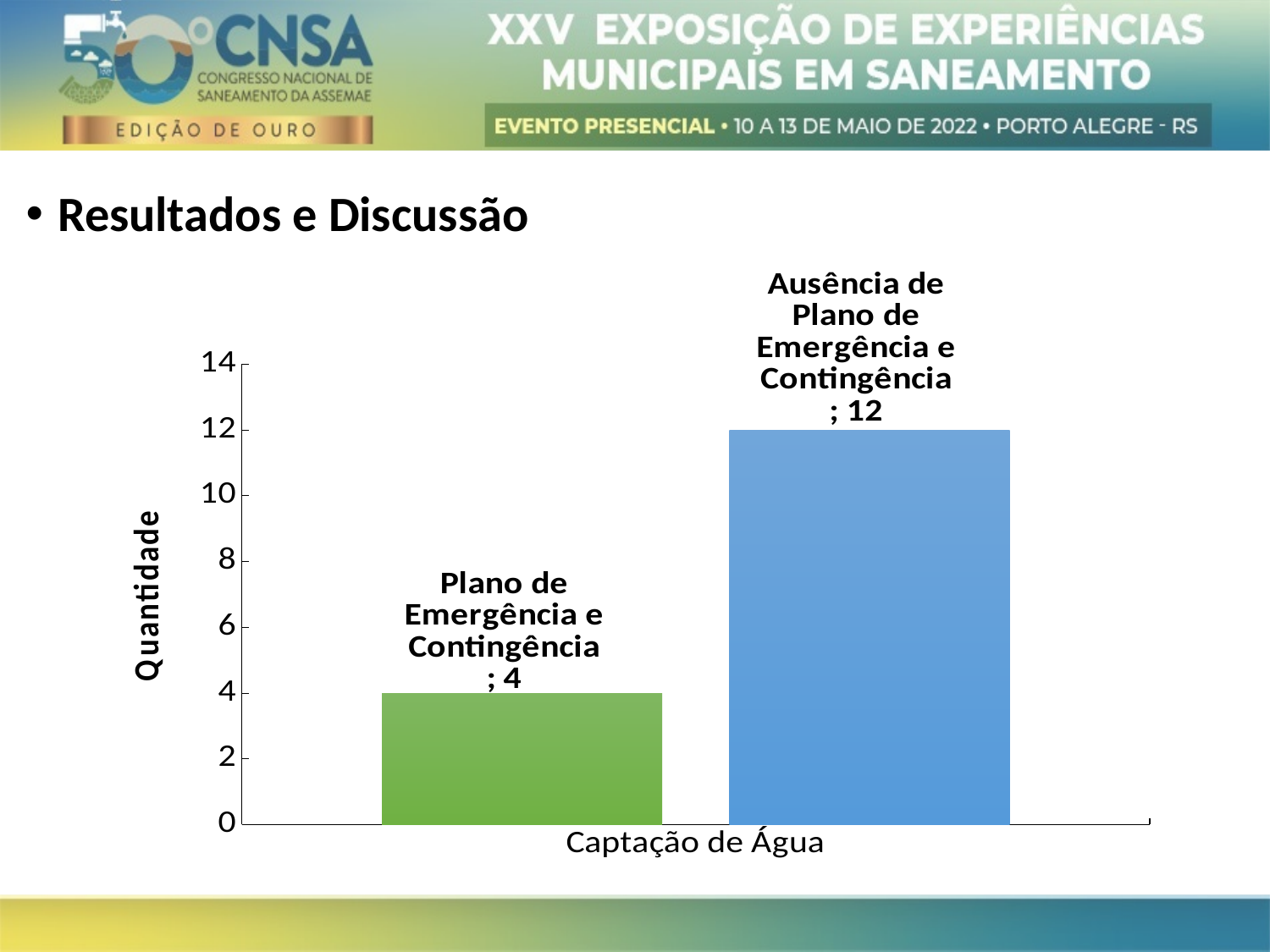
Is the value for 'Plano de Emergência e Contingência' greater or less than 6? less What is the category label shown on the horizontal axis? Captação de Água What kind of chart is shown on the slide? bar chart Which series has the highest value? Ausência de Plano de Emergência e Contingência How many bars are plotted in the chart? 2 What is the label of the vertical axis? Quantidade What is the difference between the values for 'Ausência de Plano de Emergência e Contingência' and 'Plano de Emergência e Contingência'? 8 What is the value for 'Plano de Emergência e Contingência'? 4 Which series has the lowest value? Plano de Emergência e Contingência Is the value for 'Ausência de Plano de Emergência e Contingência' greater or less than 10? greater Which is larger: the value for 'Plano de Emergência e Contingência' or for 'Ausência de Plano de Emergência e Contingência'? Ausência de Plano de Emergência e Contingência What is the value for 'Ausência de Plano de Emergência e Contingência'? 12